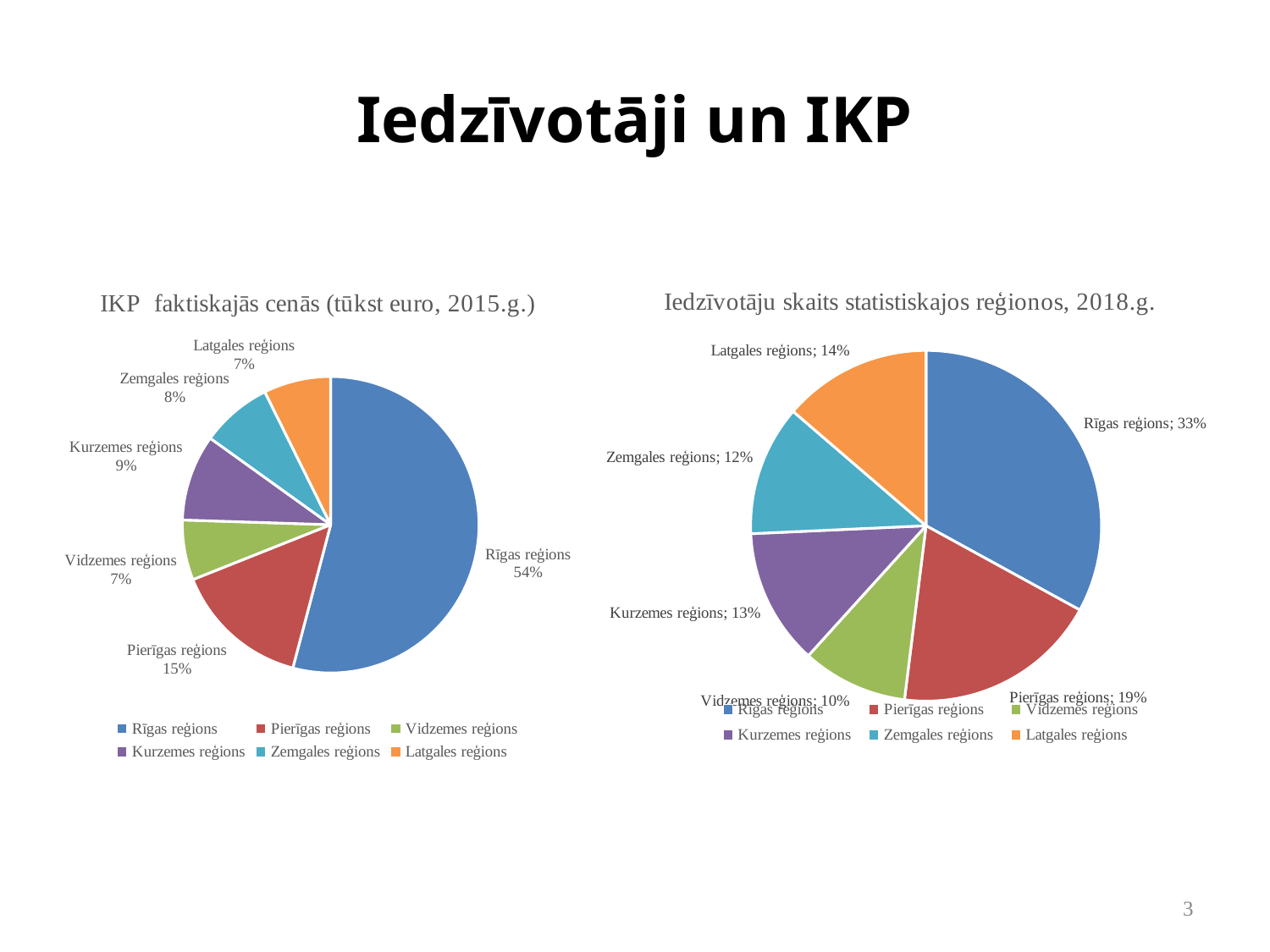
What kind of chart is the chart titled "Iedzīvotāju skaits statistiskajos reģionos, 2018.g."? Pie chart How many slices does the chart titled "IKP faktiskajās cenās (tūkst euro, 2015.g.)" have? 6 In the chart titled "Iedzīvotāju skaits statistiskajos reģionos, 2018.g.", what share does Kurzemes reģions have? 13% In the chart titled "Iedzīvotāju skaits statistiskajos reģionos, 2018.g.", what share does Latgales reģions have? 14% In the chart titled "IKP faktiskajās cenās (tūkst euro, 2015.g.)", what is the difference between the shares of Rīgas reģions and Pierīgas reģions? 39% In the chart titled "IKP faktiskajās cenās (tūkst euro, 2015.g.)", which region has the largest share? Rīgas reģions In the chart titled "Iedzīvotāju skaits statistiskajos reģionos, 2018.g.", which region has the largest share? Rīgas reģions In the chart titled "Iedzīvotāju skaits statistiskajos reģionos, 2018.g.", which is larger, the share of Zemgales reģions or Pierīgas reģions? Pierīgas reģions In the chart titled "IKP faktiskajās cenās (tūkst euro, 2015.g.)", what colour is the slice for Latgales reģions? Orange In the chart titled "Iedzīvotāju skaits statistiskajos reģionos, 2018.g.", which region has the smallest share? Vidzemes reģions In the chart titled "IKP faktiskajās cenās (tūkst euro, 2015.g.)", what share does Rīgas reģions have? 54%